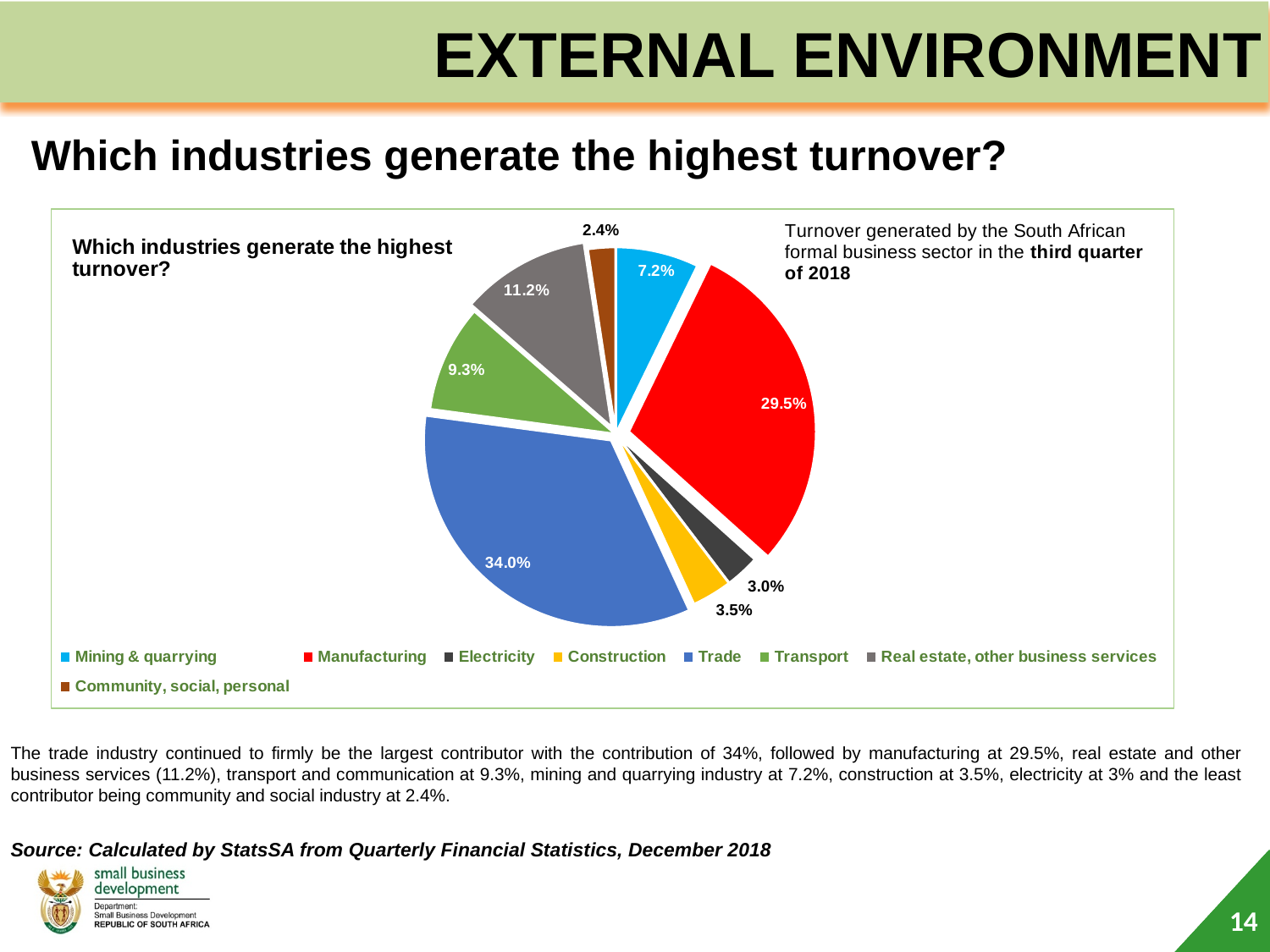
What is the difference between the Transport and Mining & quarrying shares? 2.1% What kind of chart is shown on the slide? Pie chart How many industries are shown in the pie chart? 8 What share of turnover does Trade account for? 34.0% What is the value for Mining & quarrying? 7.2% Which industry has the largest slice of the pie? Trade What is the value shown for Manufacturing? 29.5% What percentage is shown for Real estate, other business services? 11.2% Which industry has the smallest slice of the pie? Community, social, personal What is the difference between the Trade and Manufacturing shares? 4.5% Which is larger, the Construction slice or the Electricity slice? Construction Which colour represents Trade in the pie chart? Blue